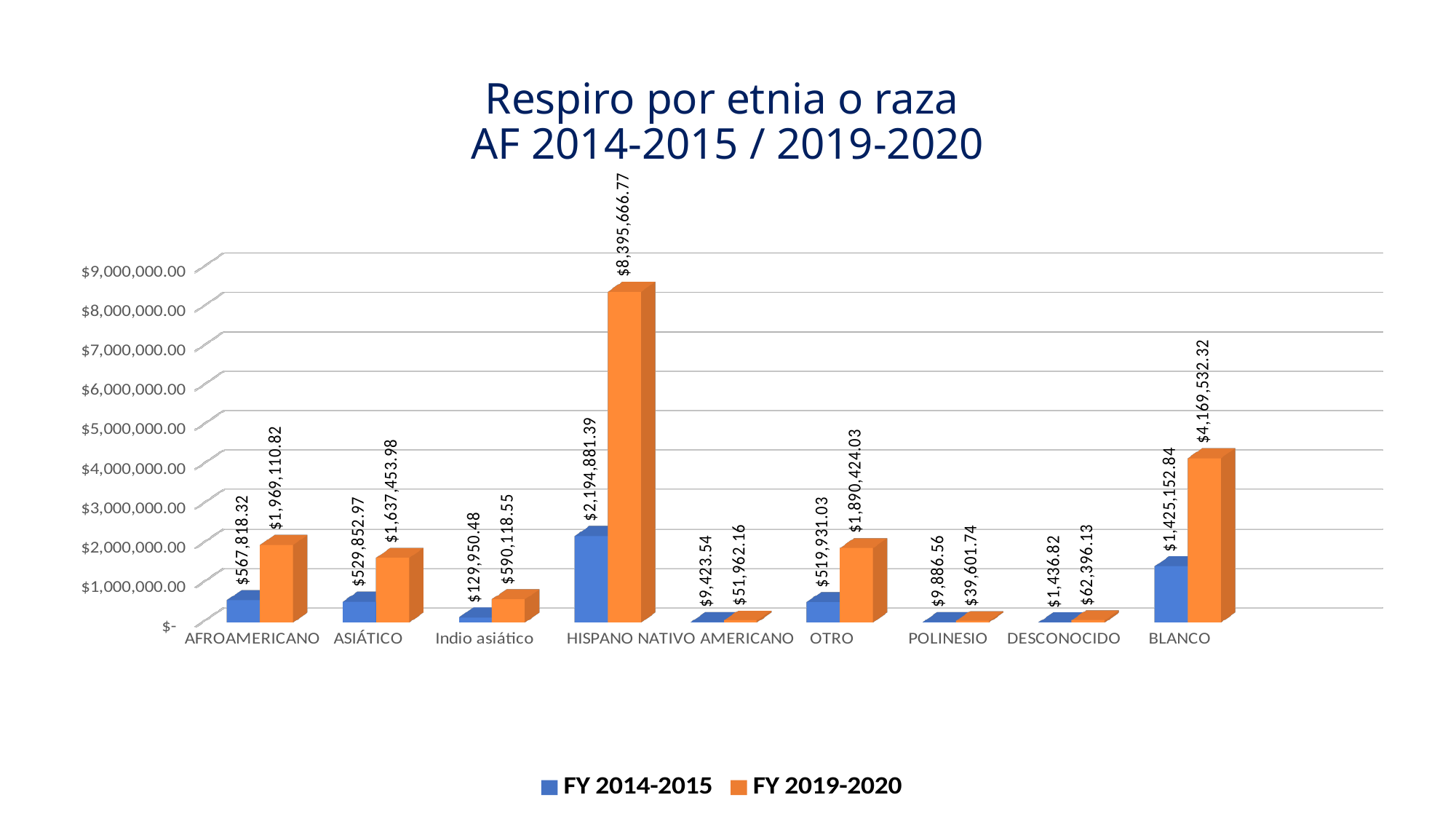
What is the title of the chart? Respiro por etnia o raza AF 2014-2015 / 2019-2020 Which category has the highest FY 2019-2020 value? HISPANO What is the difference between the FY 2019-2020 and FY 2014-2015 values for HISPANO? $6,200,785.38 What type of chart is shown on the slide? Bar chart How many series does the legend list? 2 Which category has the lowest FY 2014-2015 value? DESCONOCIDO How many categories are shown on the x axis? 9 Which category has the lowest FY 2019-2020 value? POLINESIO What is the FY 2019-2020 value for HISPANO? $8,395,666.77 What is the FY 2014-2015 value for BLANCO? $1,425,152.84 What is the FY 2019-2020 value for Indio asiático? $590,118.55 Which is larger: the FY 2019-2020 value for AFROAMERICANO or the FY 2019-2020 value for OTRO? AFROAMERICANO